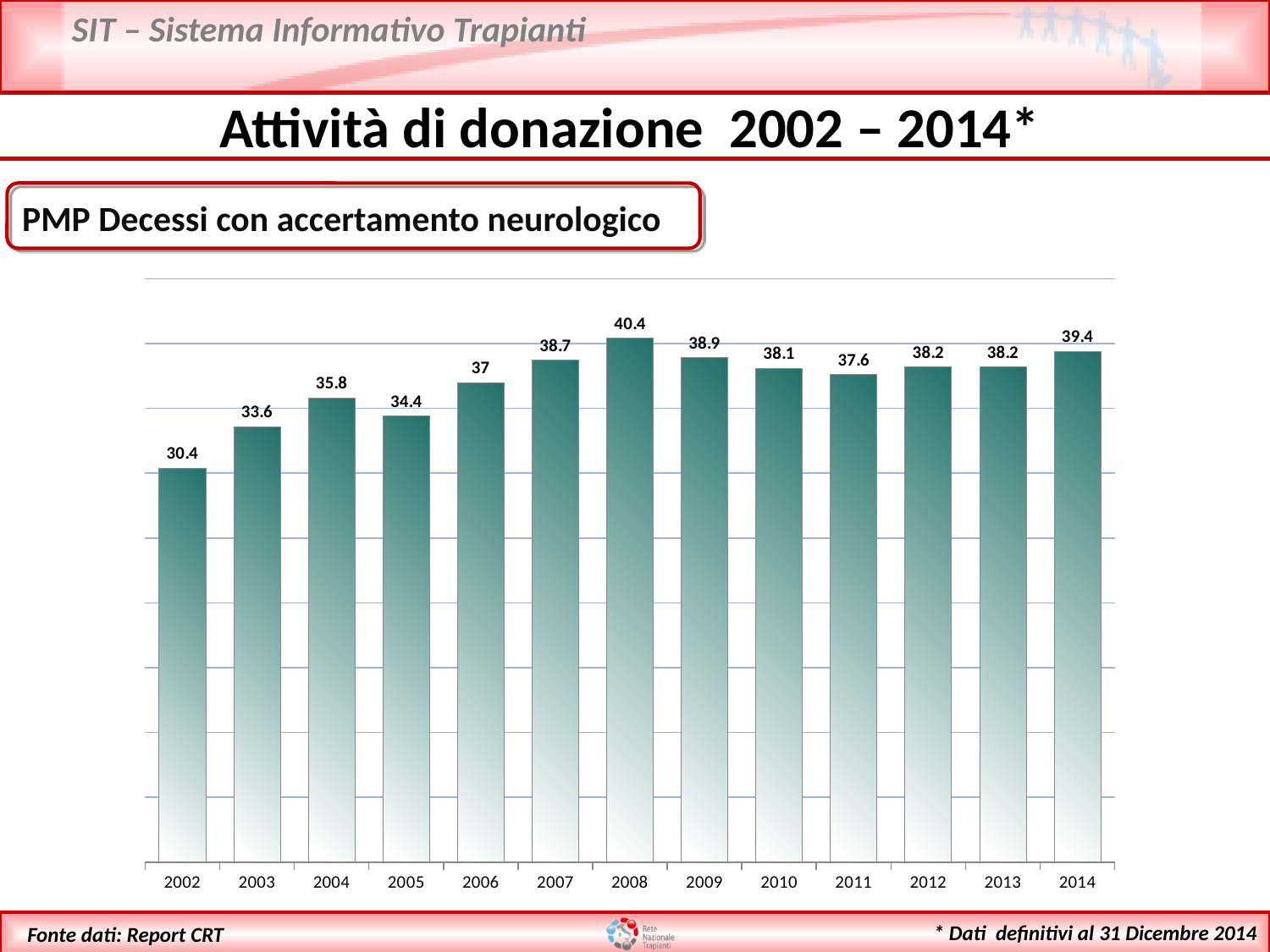
How many years are shown on the x axis? 13 Which is larger, the value for 2005 or the value for 2006? 2006 What is the value for 2002? 30.4 What is the value for 2006? 37 What is the value for 2014? 39.4 Which year has the highest value? 2008 What is the title shown in the box above the chart? PMP Decessi con accertamento neurologico What kind of chart is shown on the slide? bar chart What is the value for 2008? 40.4 What is the difference between the values for 2008 and 2002? 10 Which year has the lowest value? 2002 What is the difference between the values for 2014 and 2013? 1.2